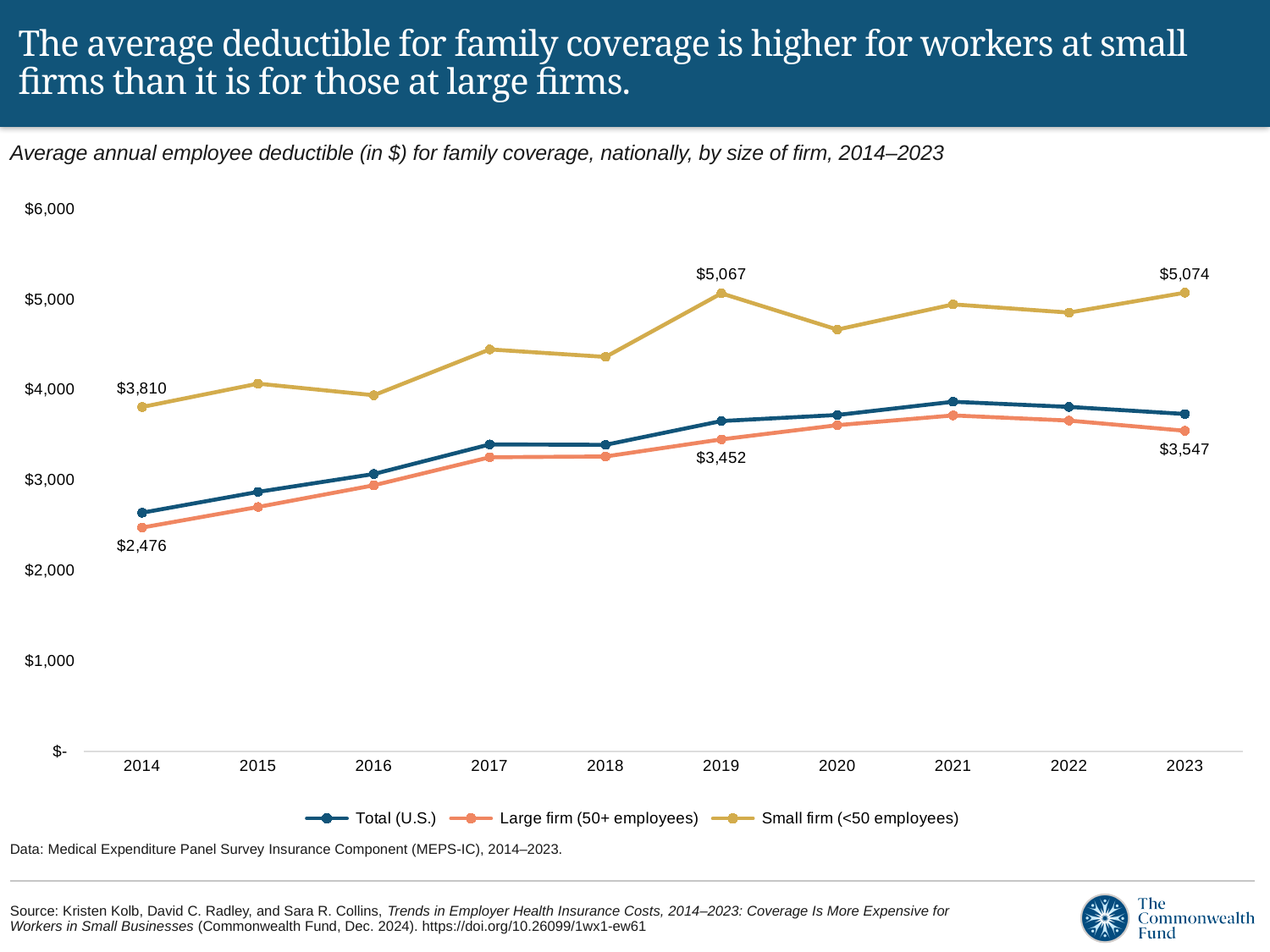
What is the difference between the small firm and large firm deductibles in 2023? $1,527 Which series has the lowest deductible in 2014? Large firm (50+ employees) What kind of chart is shown on the slide? Line chart How many years are shown on the x axis? 10 By how much did the large firm deductible increase from 2014 to 2023? $1,071 What is the value for small firms (<50 employees) in 2019? $5,067 How many series does the legend list? 3 Which series has the highest deductible in 2023? Small firm (<50 employees) What is the average annual deductible for family coverage at small firms (<50 employees) in 2014? $3,810 Is the Total (U.S.) deductible in 2021 greater or less than $4,000? less What is the value for large firms (50+ employees) in 2014? $2,476 What is the average annual deductible for family coverage at large firms (50+ employees) in 2023? $3,547